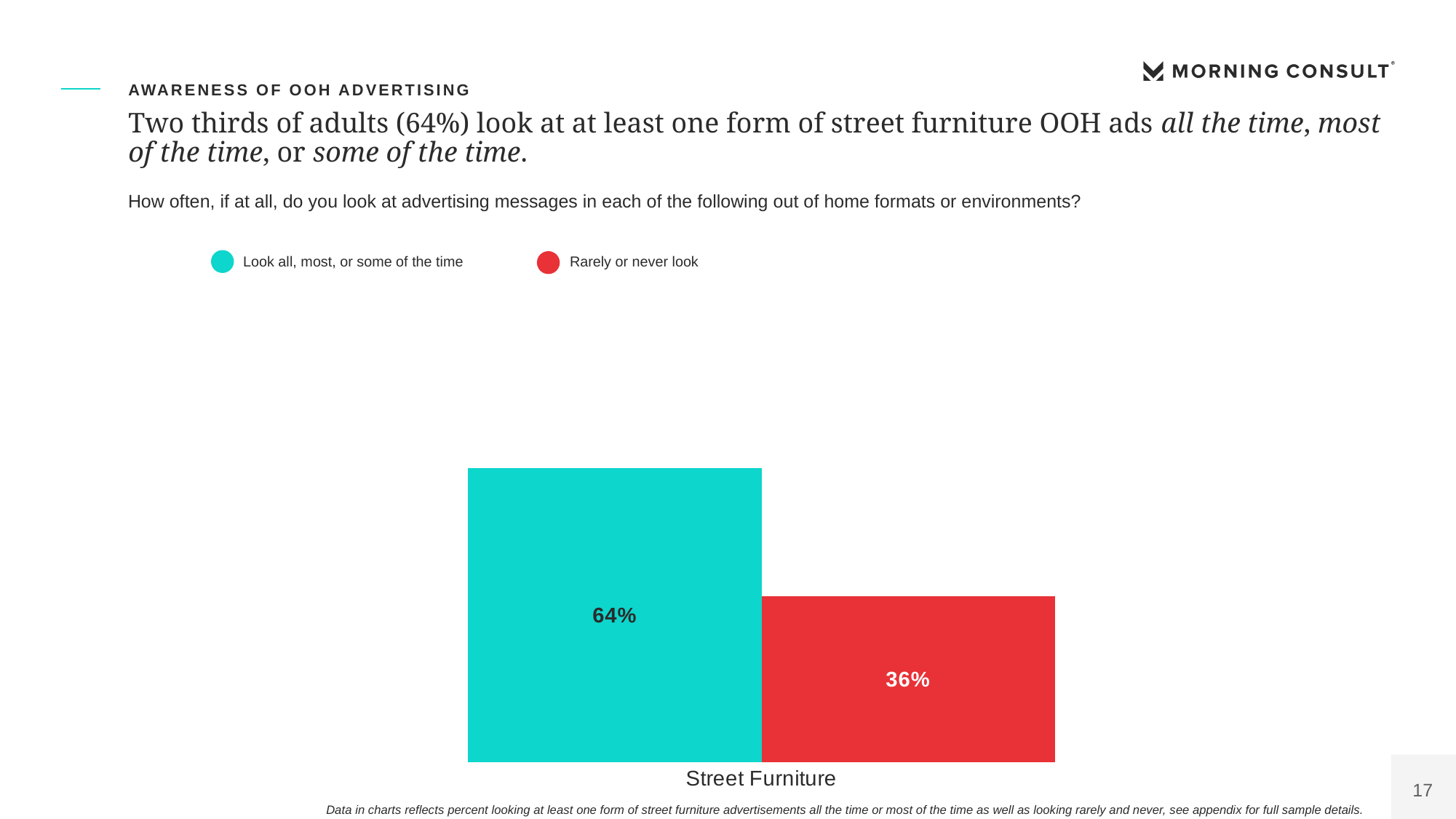
What is the total of the two values shown for Street Furniture? 100% Which series has the higher value for Street Furniture? Look all, most, or some of the time What percentage of adults look at street furniture OOH ads all, most, or some of the time? 64% What kind of chart is shown on the slide? bar chart What is the category label shown below the bars? Street Furniture Is the value for 'Look all, most, or some of the time' larger or smaller than the value for 'Rarely or never look'? larger What colour is the bar for 'Rarely or never look'? red How many series does the legend list? 2 How many categories are shown on the x axis? 1 What is the difference between the 'Look all, most, or some of the time' value and the 'Rarely or never look' value? 28% What percentage of adults rarely or never look at street furniture OOH ads? 36% Which series has the lower value for Street Furniture? Rarely or never look